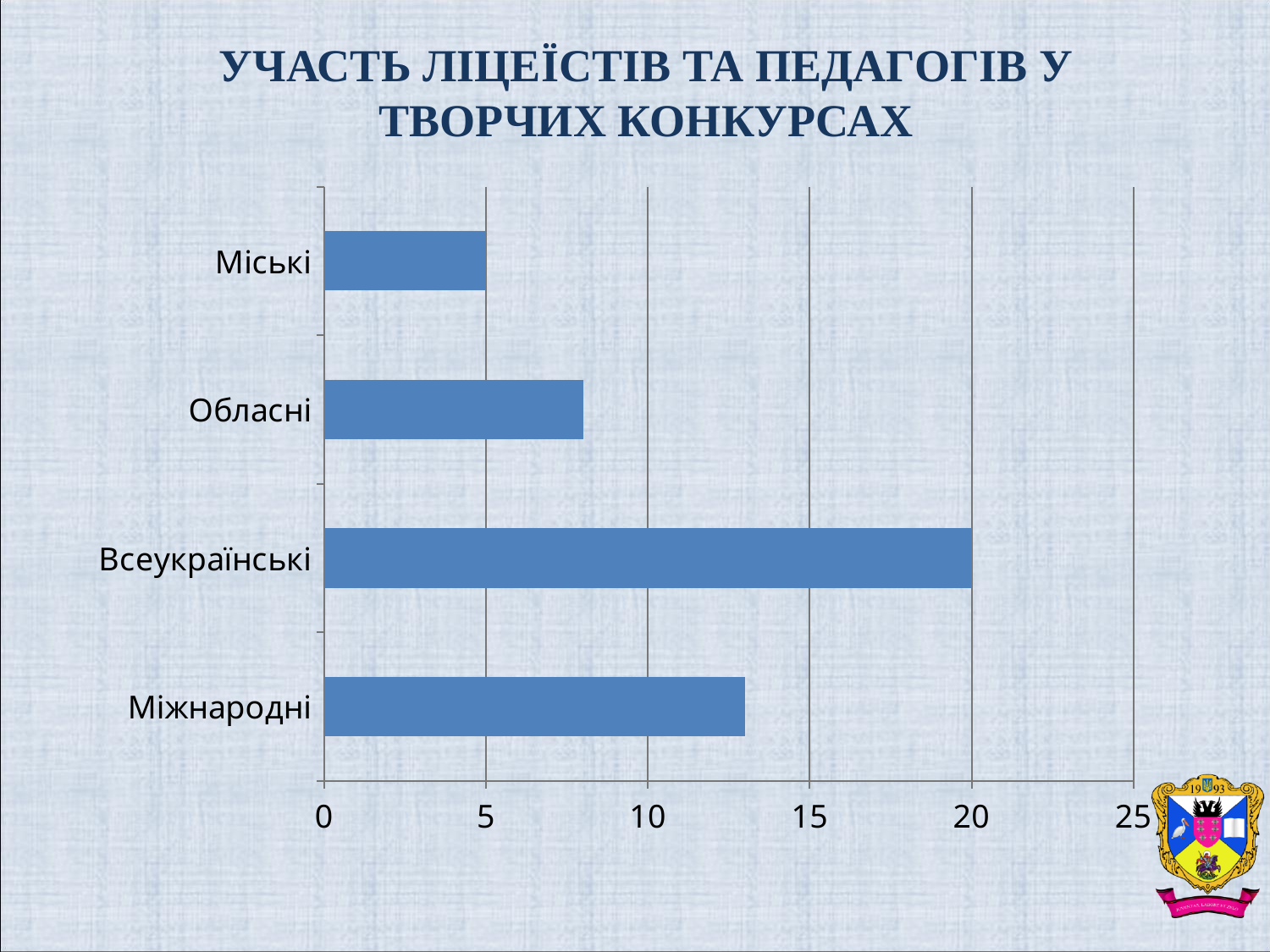
Which category has the highest value? Всеукраїнські Is the value for Обласні greater or less than 10? less What is the value for Міські? 5 Is the value for Міжнародні greater or less than 15? less What is the difference between the values for Всеукраїнські and Міські? 15 How many categories are shown in the chart? 4 What kind of chart is shown on the slide? bar chart Is the value for Міжнародні greater or less than 10? greater What is the value for Всеукраїнські? 20 Which is larger, the value for Обласні or the value for Міжнародні? Міжнародні Which category has the lowest value? Міські What is the title of the slide? УЧАСТЬ ЛІЦЕЇСТІВ ТА ПЕДАГОГІВ У ТВОРЧИХ КОНКУРСАХ